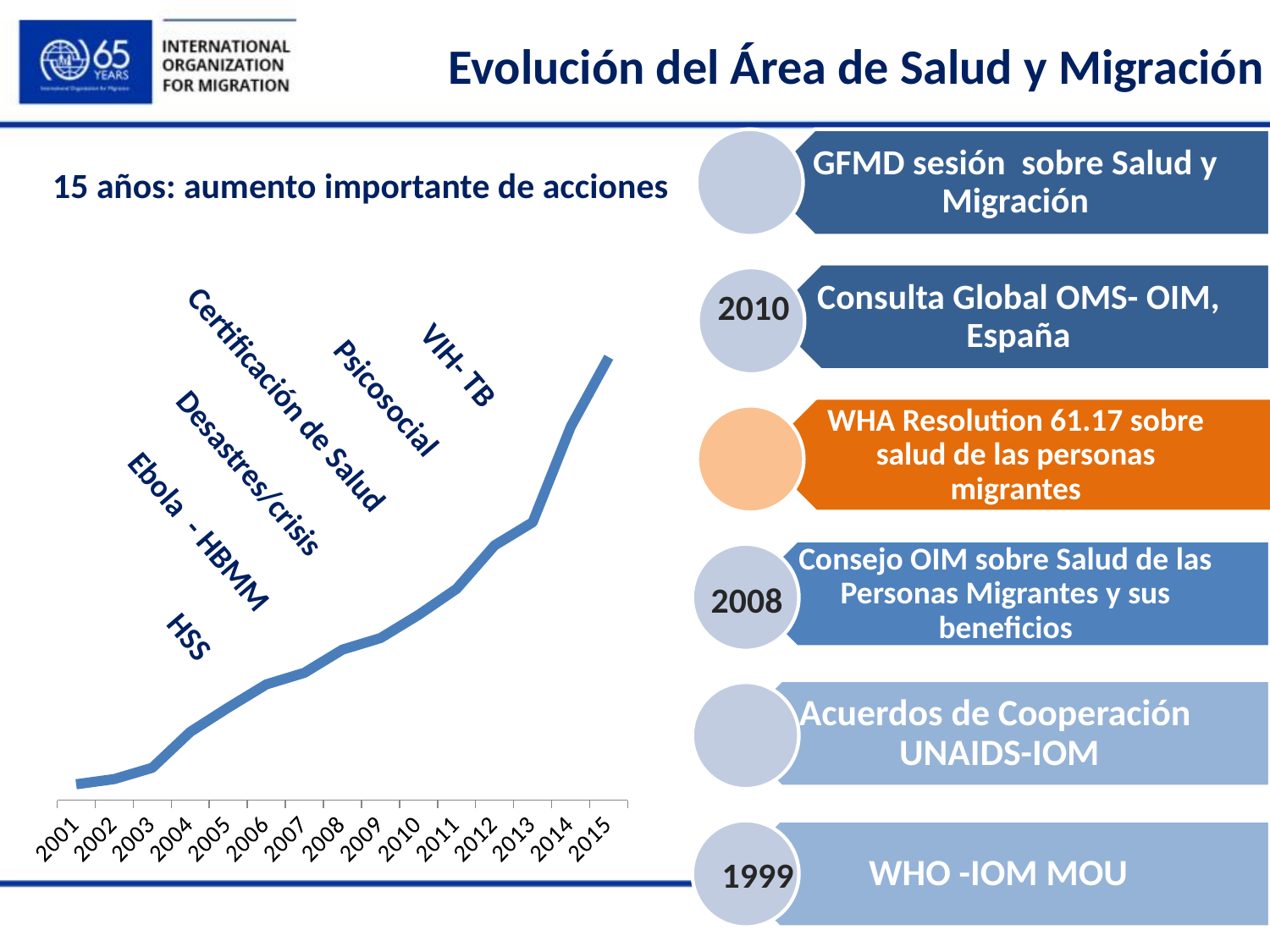
What colour is the line in the line chart? Blue Do the values in the line chart rise or fall from 2001 to 2015? Rise How many years are marked along the x axis of the line chart? 15 What is the heading printed above the line chart? 15 años: aumento importante de acciones In the line chart, is the value for 2013 larger or smaller than the value for 2005? Larger What is the last year shown on the x axis of the line chart? 2015 In which year does the line chart reach its highest value? 2015 What is the first year shown on the x axis of the line chart? 2001 In which year does the line chart show its lowest value? 2001 What kind of chart is shown on the left of the slide? Line chart In the line chart, which year has the larger value, 2002 or 2014? 2014